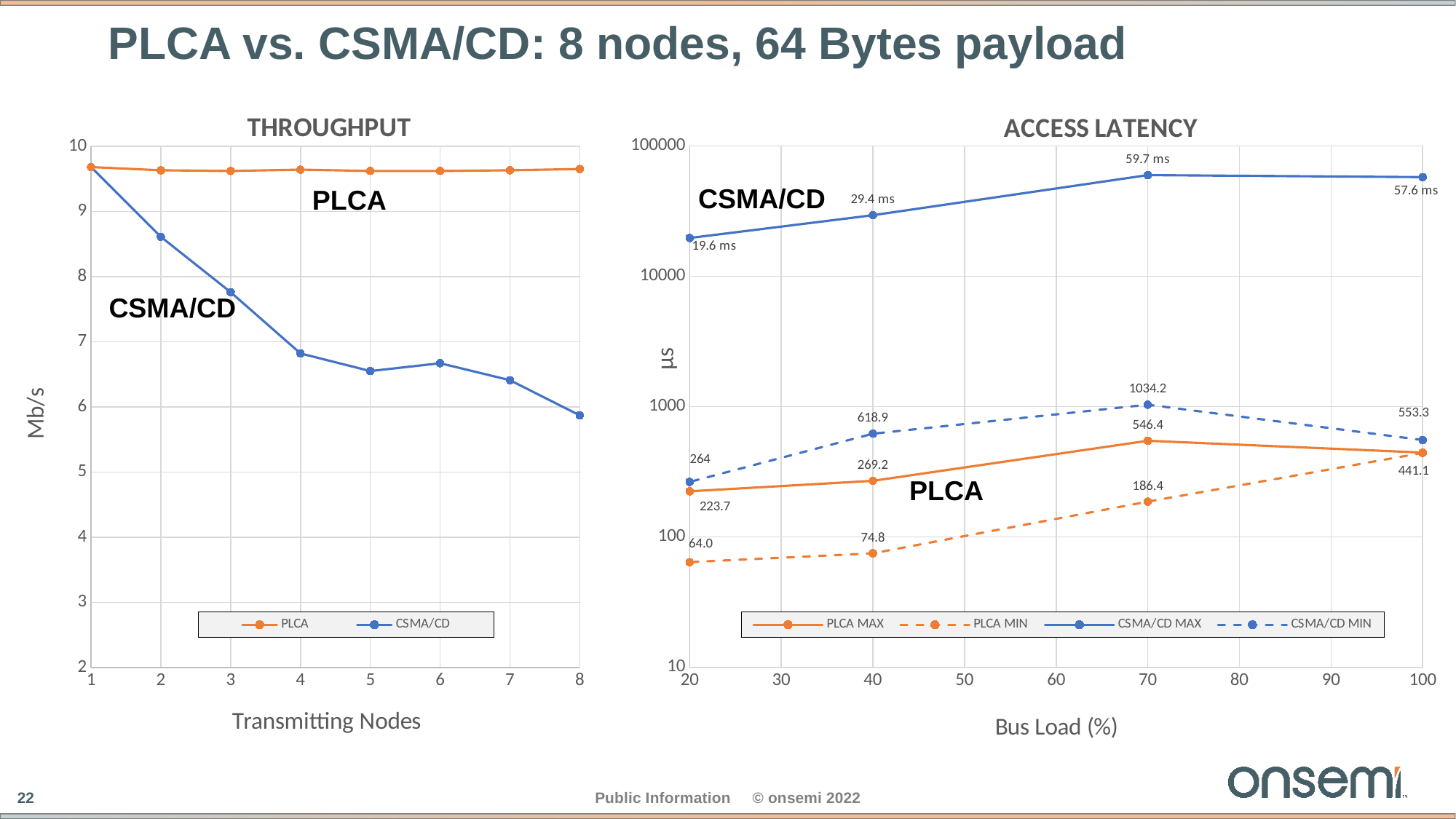
On the ACCESS LATENCY chart, what is the CSMA/CD MAX value at 70% bus load? 59.7 ms On the THROUGHPUT chart, does the CSMA/CD throughput rise or fall as the number of transmitting nodes increases? fall On the ACCESS LATENCY chart, what is the PLCA MAX value at 70% bus load? 546.4 On the THROUGHPUT chart, is the CSMA/CD value at 4 transmitting nodes greater or less than 7 Mb/s? less On the THROUGHPUT chart, how many transmitting-node values are plotted along the x axis? 8 On the ACCESS LATENCY chart, what is the difference between the CSMA/CD MIN value and the PLCA MAX value at 70% bus load? 487.8 On the THROUGHPUT chart, how many series does the legend list? 2 On the ACCESS LATENCY chart, at which bus load is the CSMA/CD MIN value highest? 70 On the THROUGHPUT chart, which series has the higher throughput at 8 transmitting nodes, PLCA or CSMA/CD? PLCA On the THROUGHPUT chart, what kind of chart is shown? line chart On the ACCESS LATENCY chart, how many series does the legend list? 4 On the THROUGHPUT chart, is the CSMA/CD value at 2 transmitting nodes greater or less than 8 Mb/s? greater